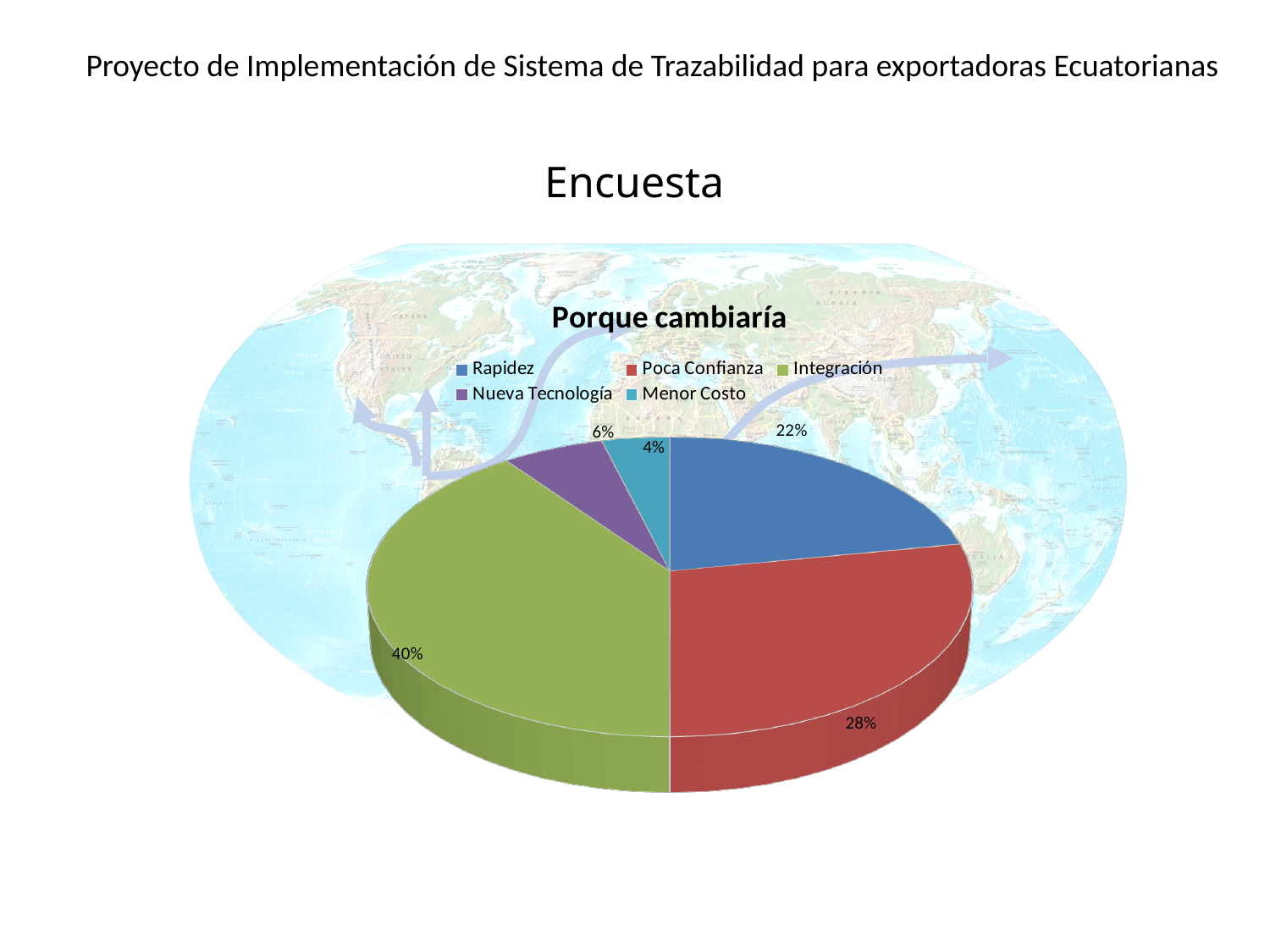
What percentage of the pie does Rapidez represent? 22% Which category has the largest share of the pie? Integración How many categories does the legend list? 5 What is the title of the chart? Porque cambiaría What is the difference in percentage points between Integración and Poca Confianza? 12 Which is larger, the share for Rapidez or the share for Poca Confianza? Poca Confianza What percentage of the pie does Menor Costo represent? 4% What percentage of the pie does Poca Confianza represent? 28% What type of chart is shown on the slide? Pie chart What percentage of the pie does Nueva Tecnología represent? 6% Which category has the smallest share of the pie? Menor Costo What percentage of the pie does Integración represent? 40%